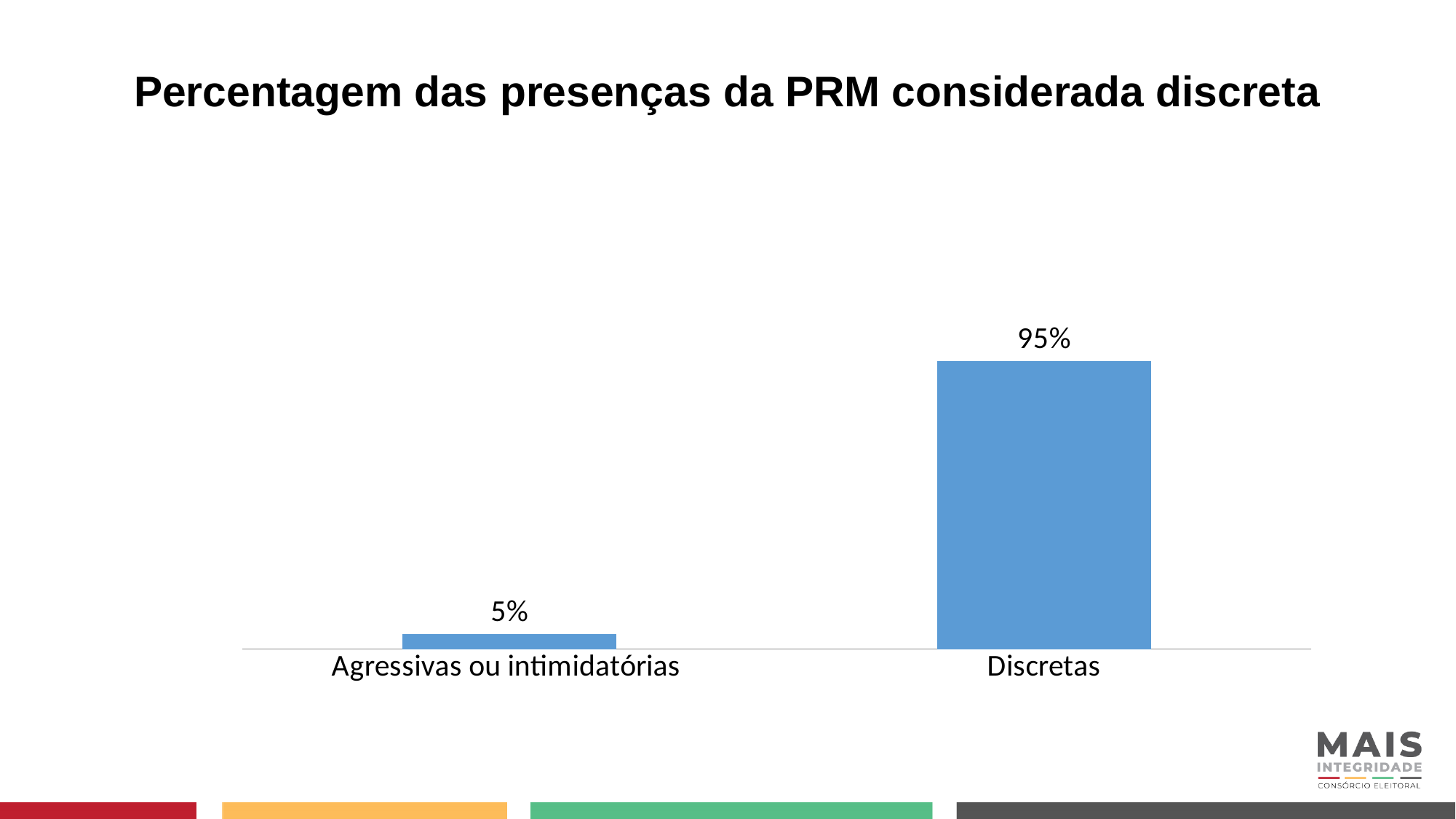
What colour are the bars in the chart? Blue What is the difference between the values for Discretas and Agressivas ou intimidatórias? 90% How many categories are shown in the chart? 2 Which category has the lowest value? Agressivas ou intimidatórias What is the total of the two values shown in the chart? 100% What is the value for Discretas? 95% Which category has the highest value? Discretas What is the title of the chart? Percentagem das presenças da PRM considerada discreta What is the value for Agressivas ou intimidatórias? 5% Which is larger, the value for Discretas or the value for Agressivas ou intimidatórias? Discretas What kind of chart is shown on the slide? Bar chart